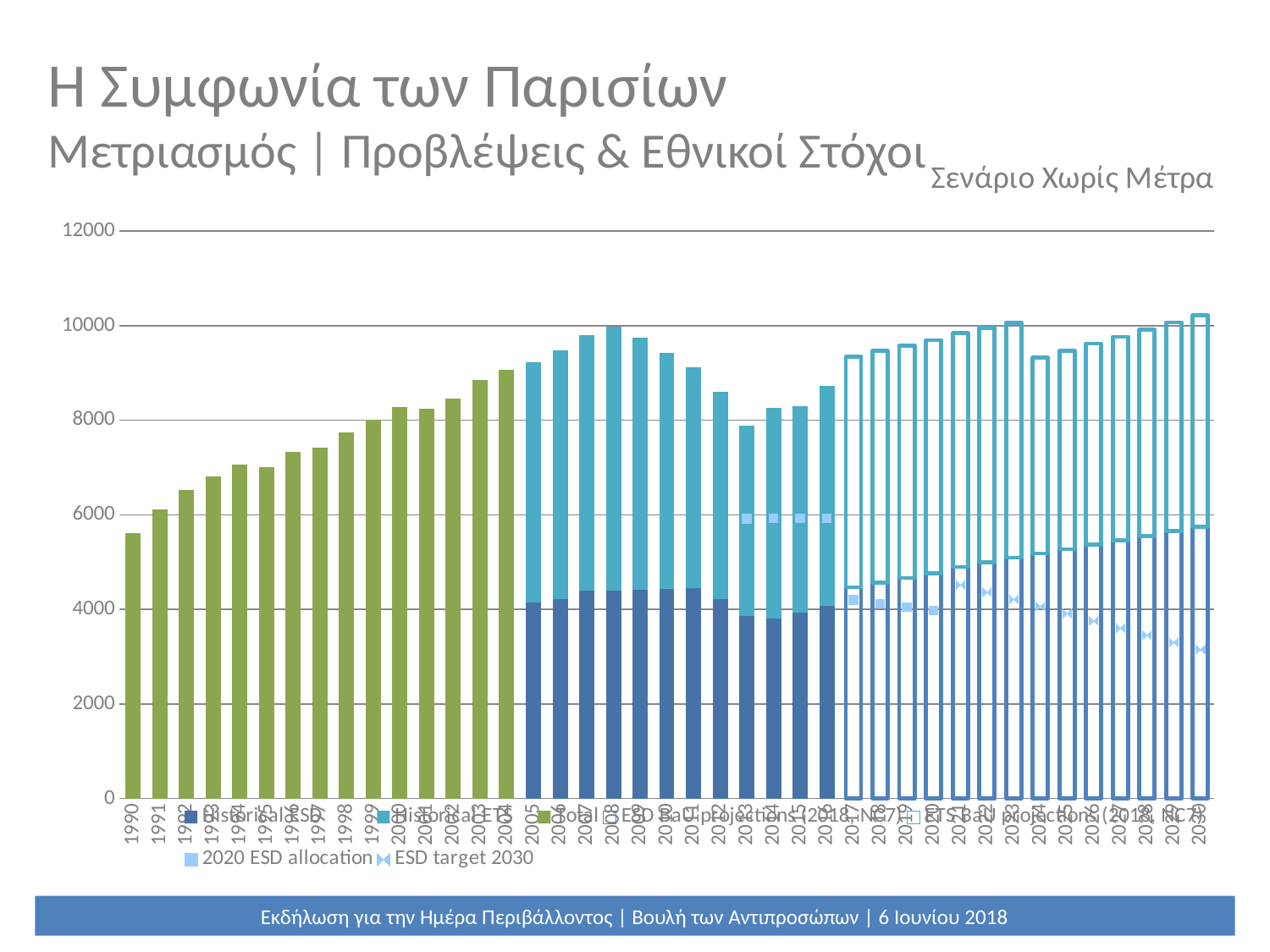
Is the total value for 1997 greater or less than 8000? less What is the title shown above the chart on the right? Σενάριο Χωρίς Μέτρα Which year has the larger total value, 1990 or 2000? 2000 Which year has the larger total value, 2008 or 2023? 2023 Which year has the lowest total value in the chart? 1990 Is the total value for 1990 greater or less than 6000? less How many series does the chart legend list? 7 How many years are shown along the x axis of the chart? 41 Do the total values rise or fall from 1990 to 2008? rise What kind of chart is shown on the slide? bar chart Is the total value for 2005 greater or less than 8000? greater